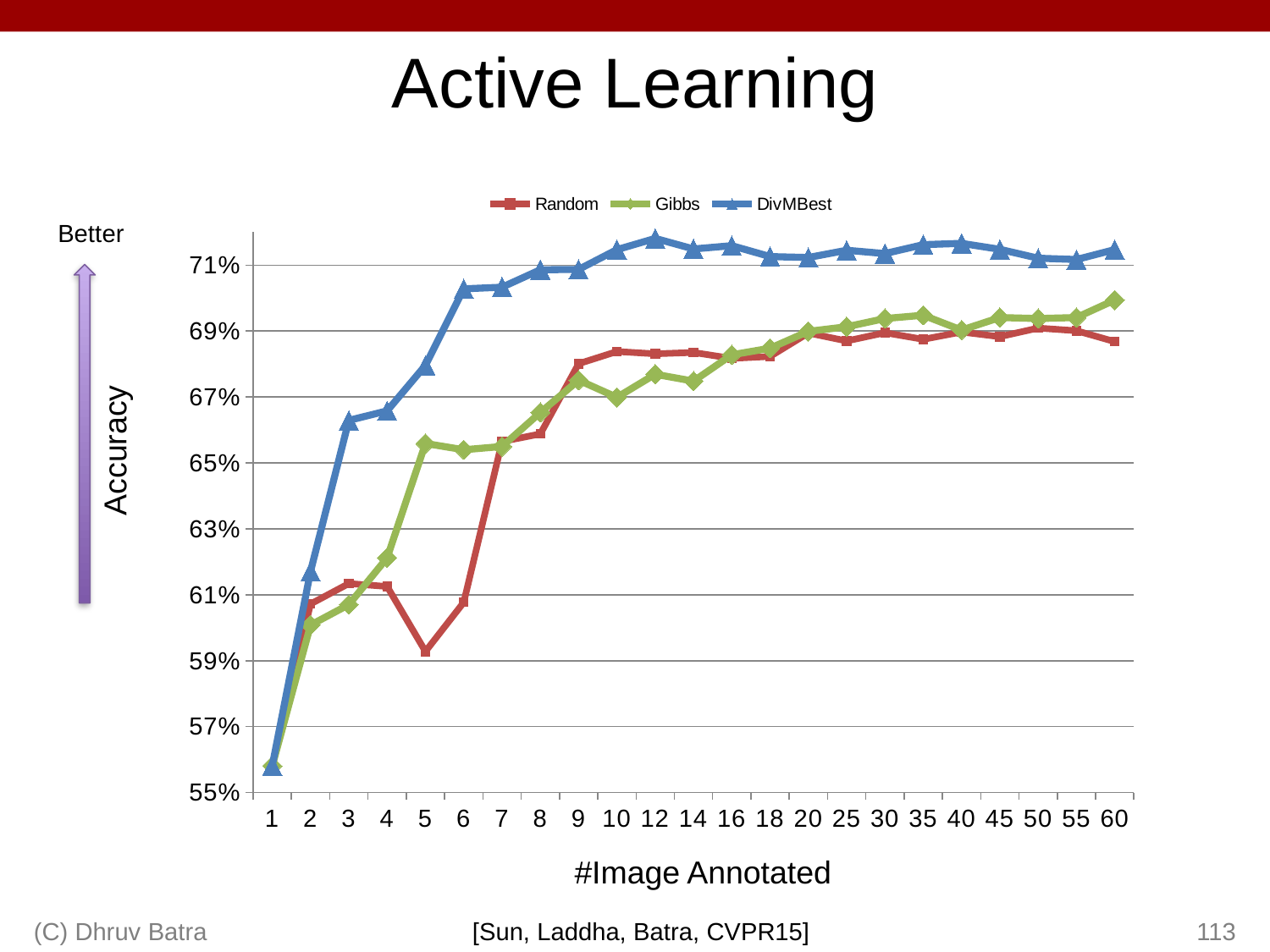
What is the label of the x axis? #Image Annotated How many points are labelled along the x axis (#Image Annotated)? 23 What kind of chart is shown on the slide? line chart Which series has the lowest accuracy at 60 images annotated? Random Is the accuracy of DivMBest at 6 images annotated greater or less than 69%? greater How many series does the legend list? 3 Which series has the highest accuracy at 60 images annotated? DivMBest Is the accuracy of DivMBest at 60 images annotated greater or less than 71%? greater Does the accuracy of DivMBest generally rise or fall as the number of images annotated increases? rise Is the accuracy of Gibbs at 4 images annotated greater or less than 63%? less At 5 images annotated, which has higher accuracy, Gibbs or Random? Gibbs